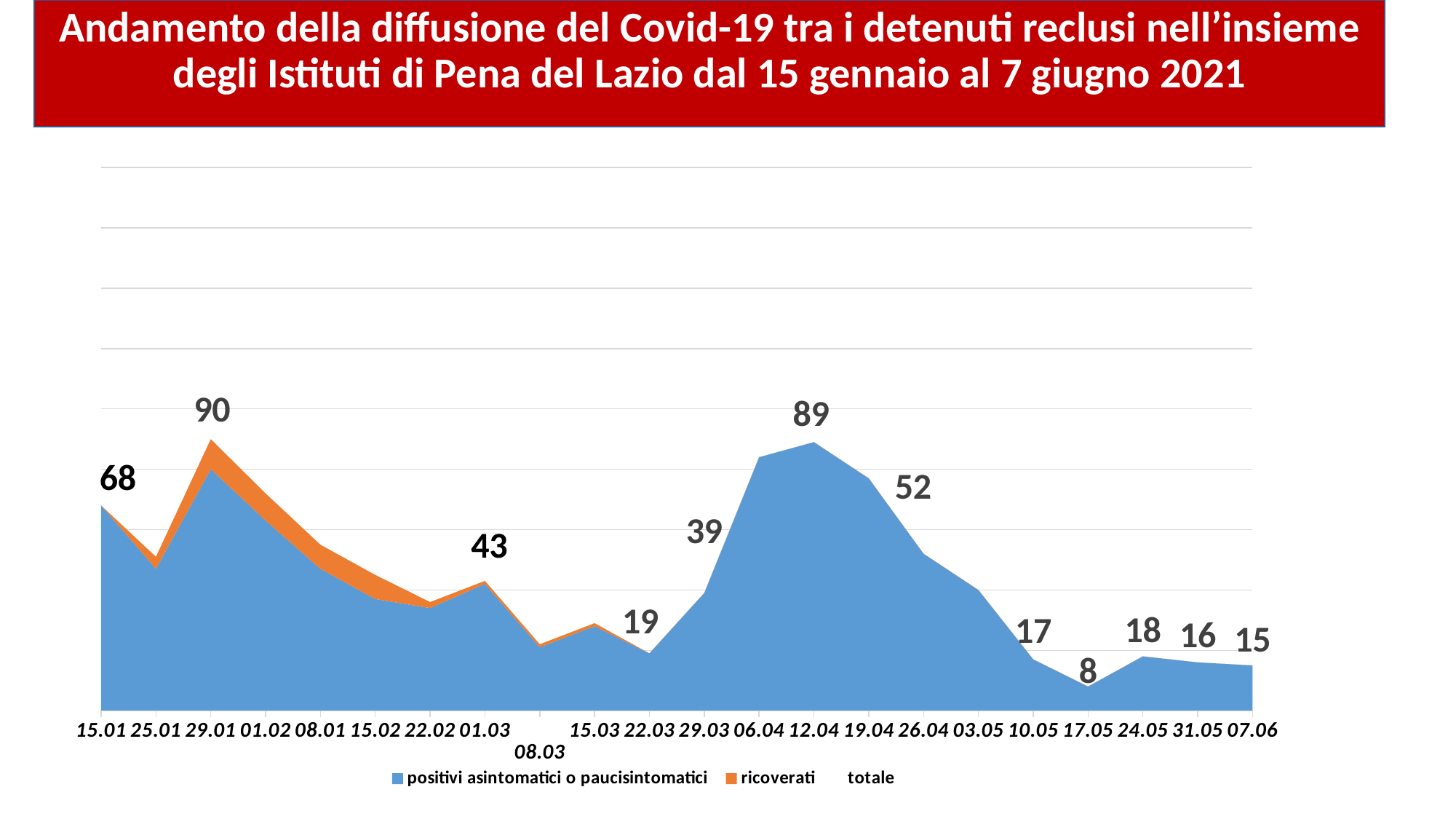
What is the difference between the labelled totals for 15.01 and 01.03? 25 What is the total value labelled for 07.06? 15 Do the labelled totals rise or fall from 12.04 to 17.05? Fall What is the total value labelled for 17.05? 8 What kind of chart is shown on the slide? Area chart What is the total value labelled for 12.04? 89 What is the total value labelled for 29.01? 90 What is the difference between the labelled totals for 29.01 and 12.04? 1 Among the labelled values, which date has the highest total? 29.01 Which is larger, the labelled total for 29.03 or for 19.04? 19.04 Among the labelled values, which date has the lowest total? 17.05 How many series does the legend list? 3